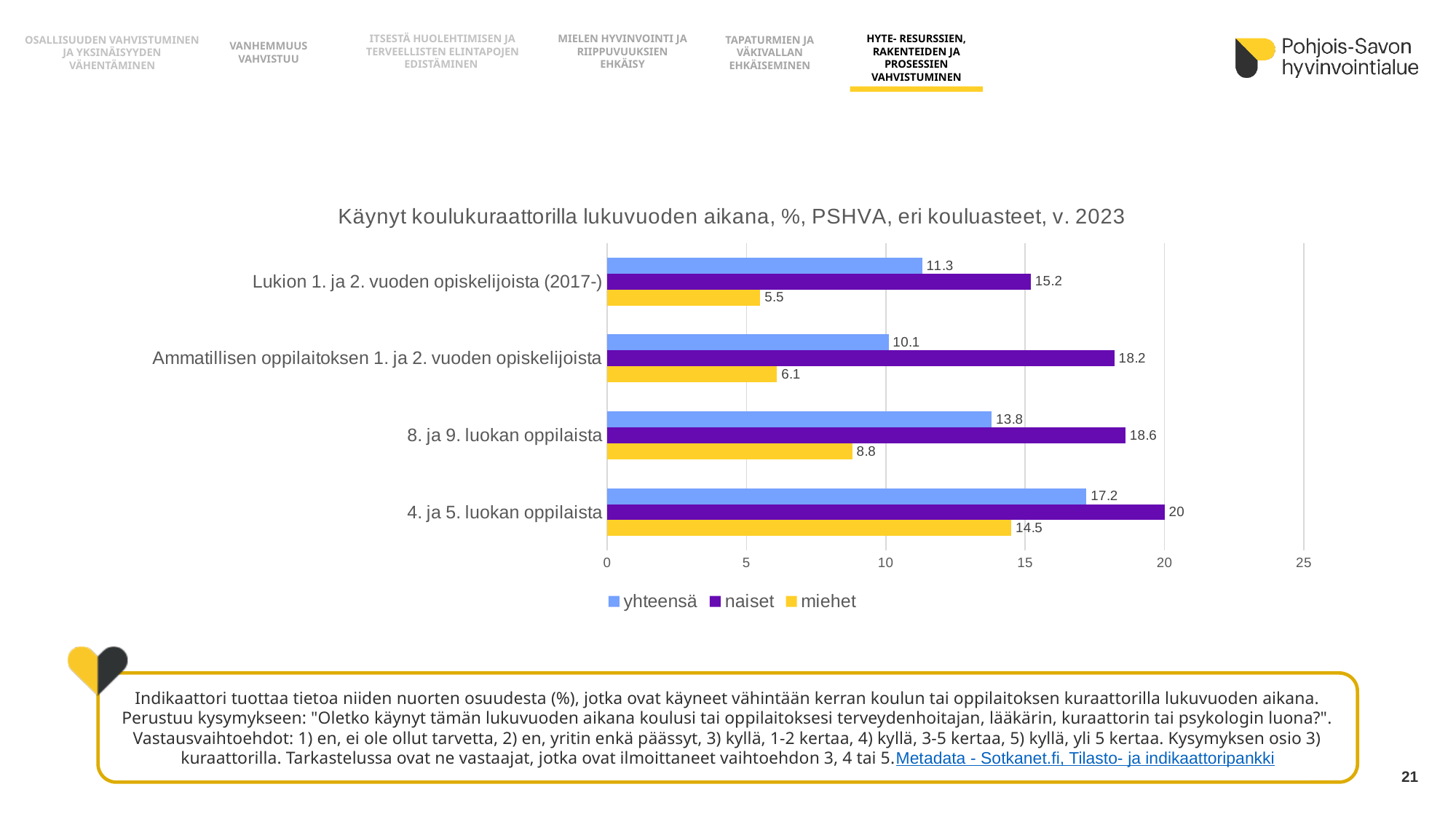
Is the 'miehet' value for '4. ja 5. luokan oppilaista' greater or less than 10? greater Which is larger: the 'naiset' value for '8. ja 9. luokan oppilaista' or the 'naiset' value for 'Ammatillisen oppilaitoksen 1. ja 2. vuoden opiskelijoista'? 8. ja 9. luokan oppilaista What kind of chart is shown on the slide? Bar chart How many series does the legend list? 3 What is the difference between the 'naiset' and 'miehet' values for 'Ammatillisen oppilaitoksen 1. ja 2. vuoden opiskelijoista'? 12.1 What is the value for 'naiset' in the '4. ja 5. luokan oppilaista' category? 20 Which category has the lowest 'miehet' value? Lukion 1. ja 2. vuoden opiskelijoista (2017-) What is the value for 'miehet' in the 'Lukion 1. ja 2. vuoden opiskelijoista (2017-)' category? 5.5 What is the 'yhteensä' value for '8. ja 9. luokan oppilaista'? 13.8 Which category has the highest 'yhteensä' value? 4. ja 5. luokan oppilaista What is the title of the chart? Käynyt koulukuraattorilla lukuvuoden aikana, %, PSHVA, eri kouluasteet, v. 2023 How many categories are shown on the chart? 4